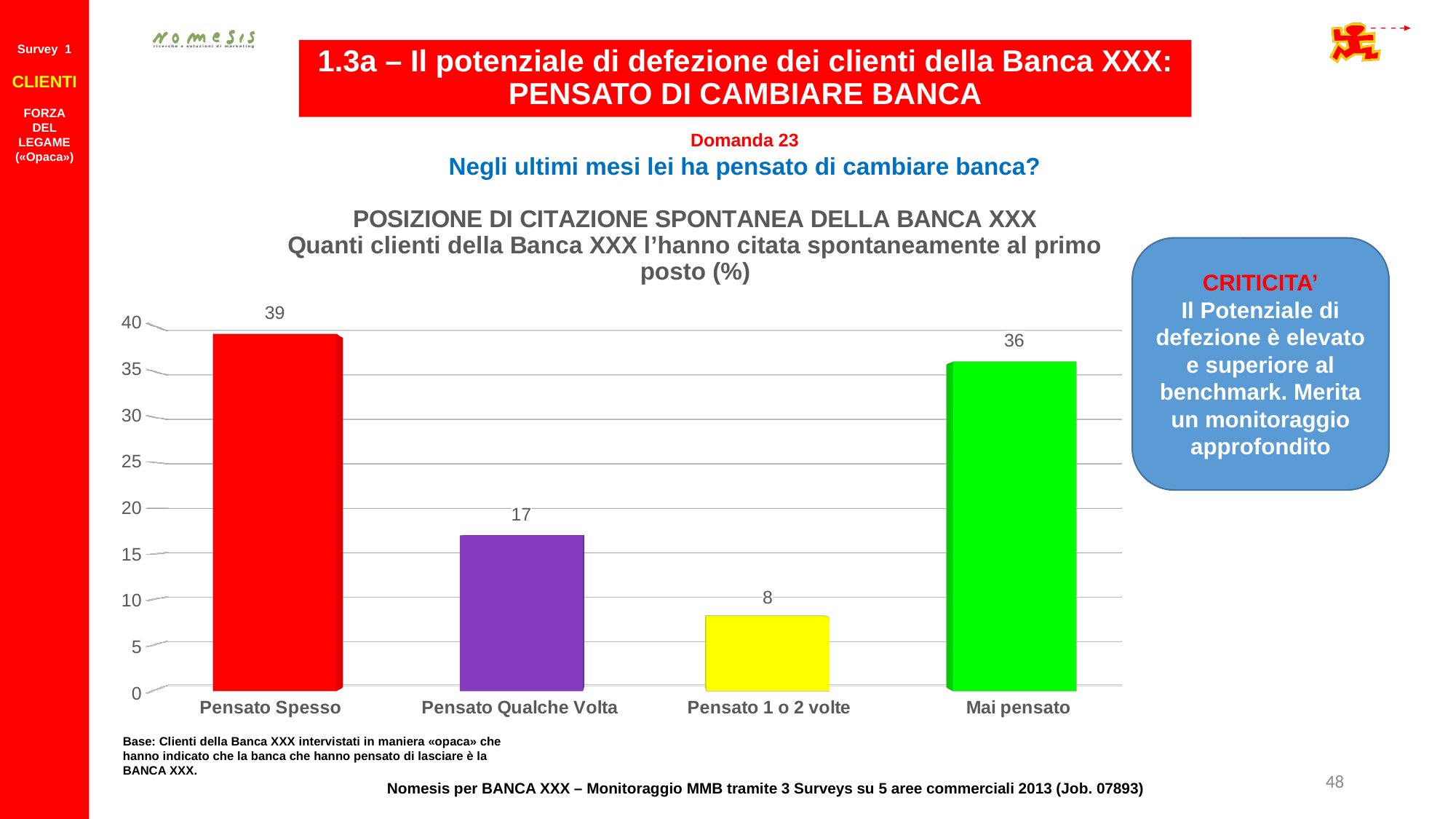
What is the value for Pensato 1 o 2 volte? 8 What kind of chart is shown on the slide? Bar chart What colour is the bar for Pensato 1 o 2 volte? Yellow What is the value for Pensato Spesso? 39 Which category has the lowest value? Pensato 1 o 2 volte What is the difference between the values for Pensato Qualche Volta and Pensato 1 o 2 volte? 9 How many categories are shown on the x axis? 4 Which is larger, the value for Pensato Qualche Volta or the value for Mai pensato? Mai pensato What is the value for Mai pensato? 36 Which category has the highest value? Pensato Spesso What is the difference between the values for Pensato Spesso and Mai pensato? 3 What is the value for Pensato Qualche Volta? 17